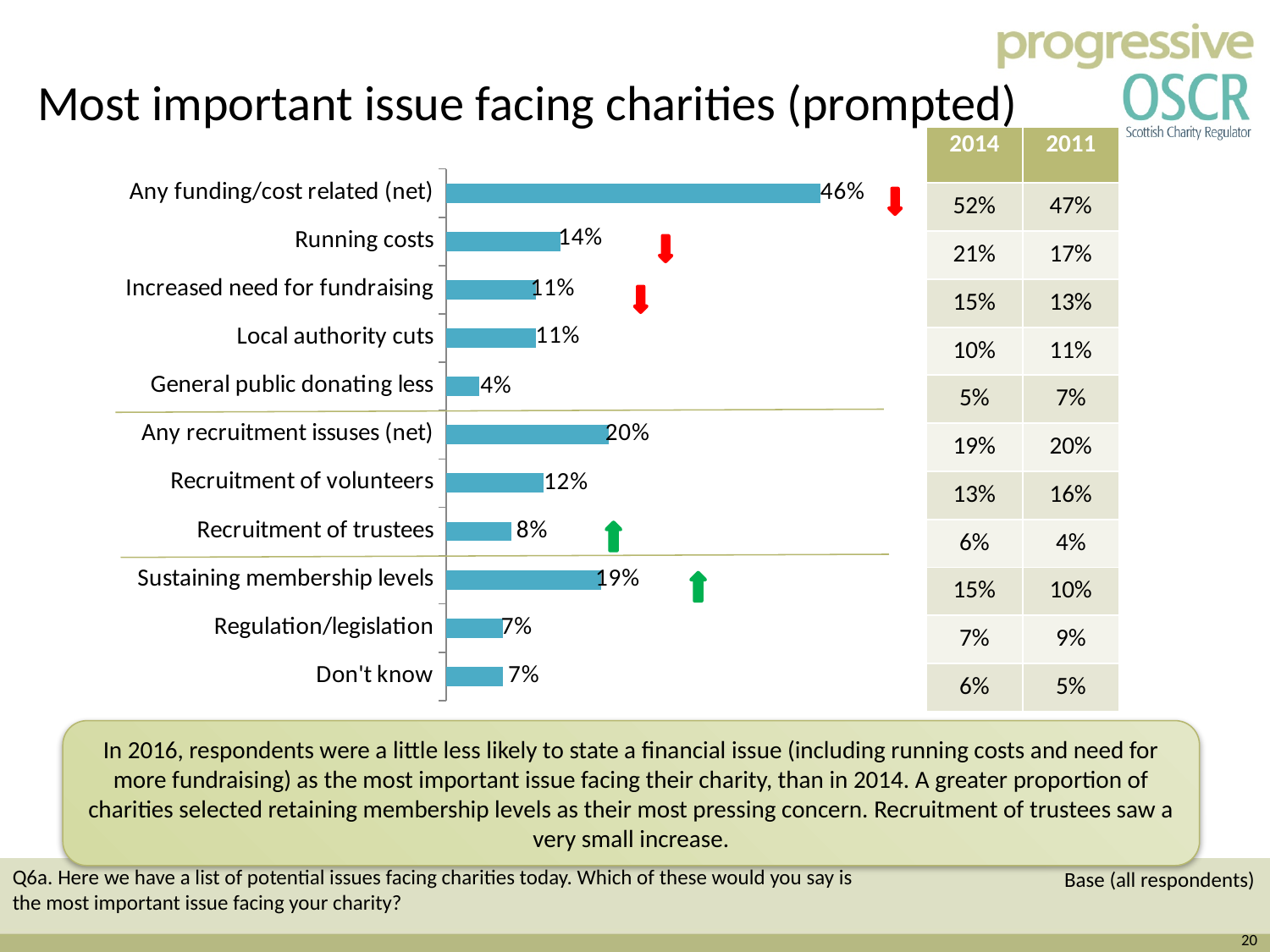
What percentage is shown for 'Any funding/cost related (net)'? 46% What is the difference between the values for 'Any funding/cost related (net)' and 'Running costs'? 32 percentage points What is the difference between the values for 'Any recruitment issues (net)' and 'Recruitment of volunteers'? 8 percentage points What is the value for 'Recruitment of trustees'? 8% Which category has the lowest value in the chart? General public donating less Which category has the highest value in the chart? Any funding/cost related (net) Which is larger, the value for 'Recruitment of volunteers' or the value for 'Recruitment of trustees'? Recruitment of volunteers What is the title of the slide containing the chart? Most important issue facing charities (prompted) What kind of chart is shown on the slide? bar chart What is the value for 'Running costs'? 14% How many categories are plotted in the bar chart? 11 What is the value for 'Sustaining membership levels'? 19%